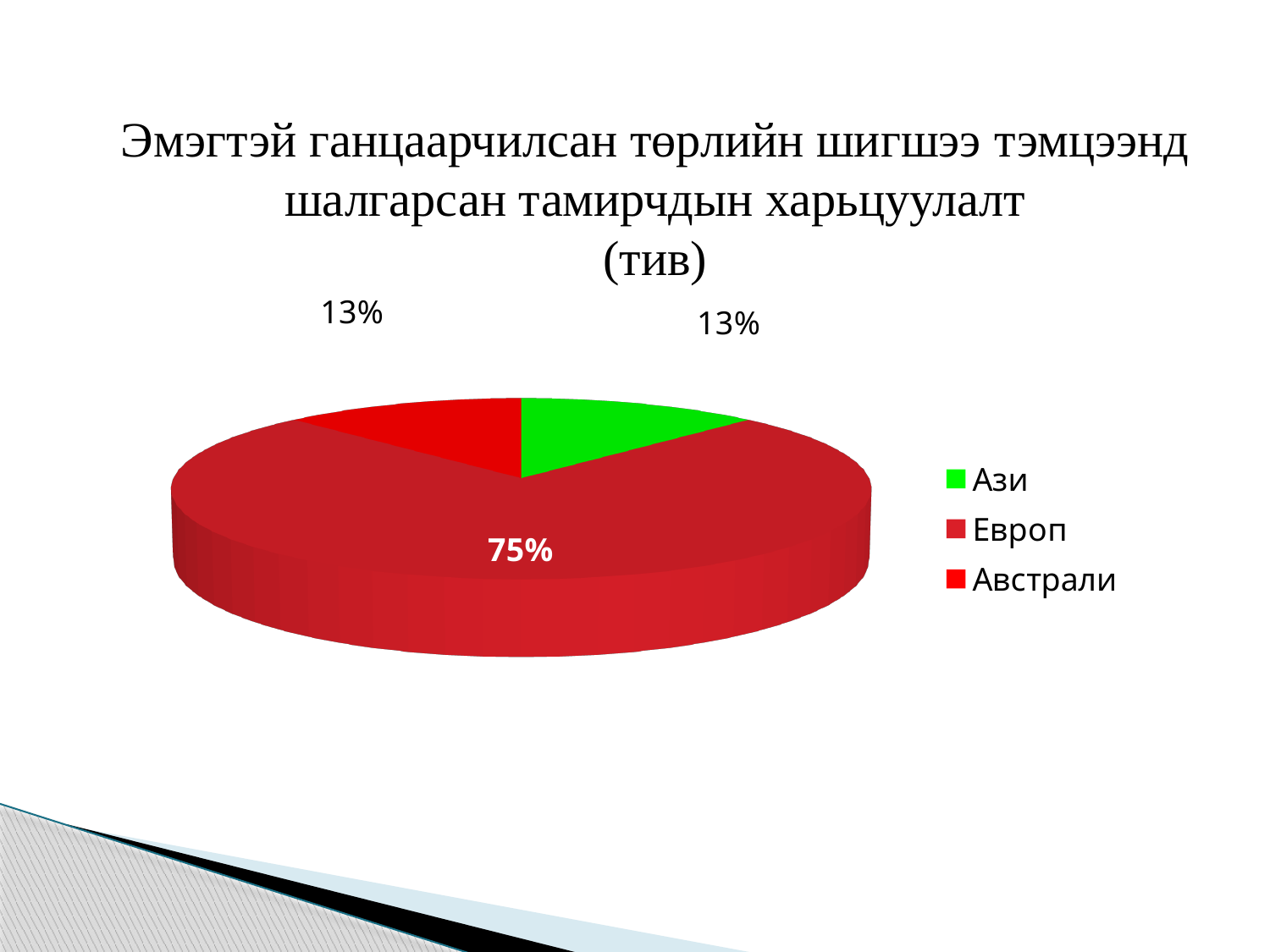
Is the share for Европ greater or less than 50%? greater What share of the pie does Ази have? 13% What share of the pie does Европ have? 75% Which category has the largest slice of the pie? Европ What colour is the Ази slice in the pie chart? green How many categories are shown in the pie chart? 3 How many entries does the legend list? 3 Which legend entry is listed last? Австрали Which slice is larger, Европ or Австрали? Европ What kind of chart is shown on the slide? pie chart What is the difference in percentage points between the Европ slice and the Ази slice? 62% What share of the pie does Австрали have? 13%